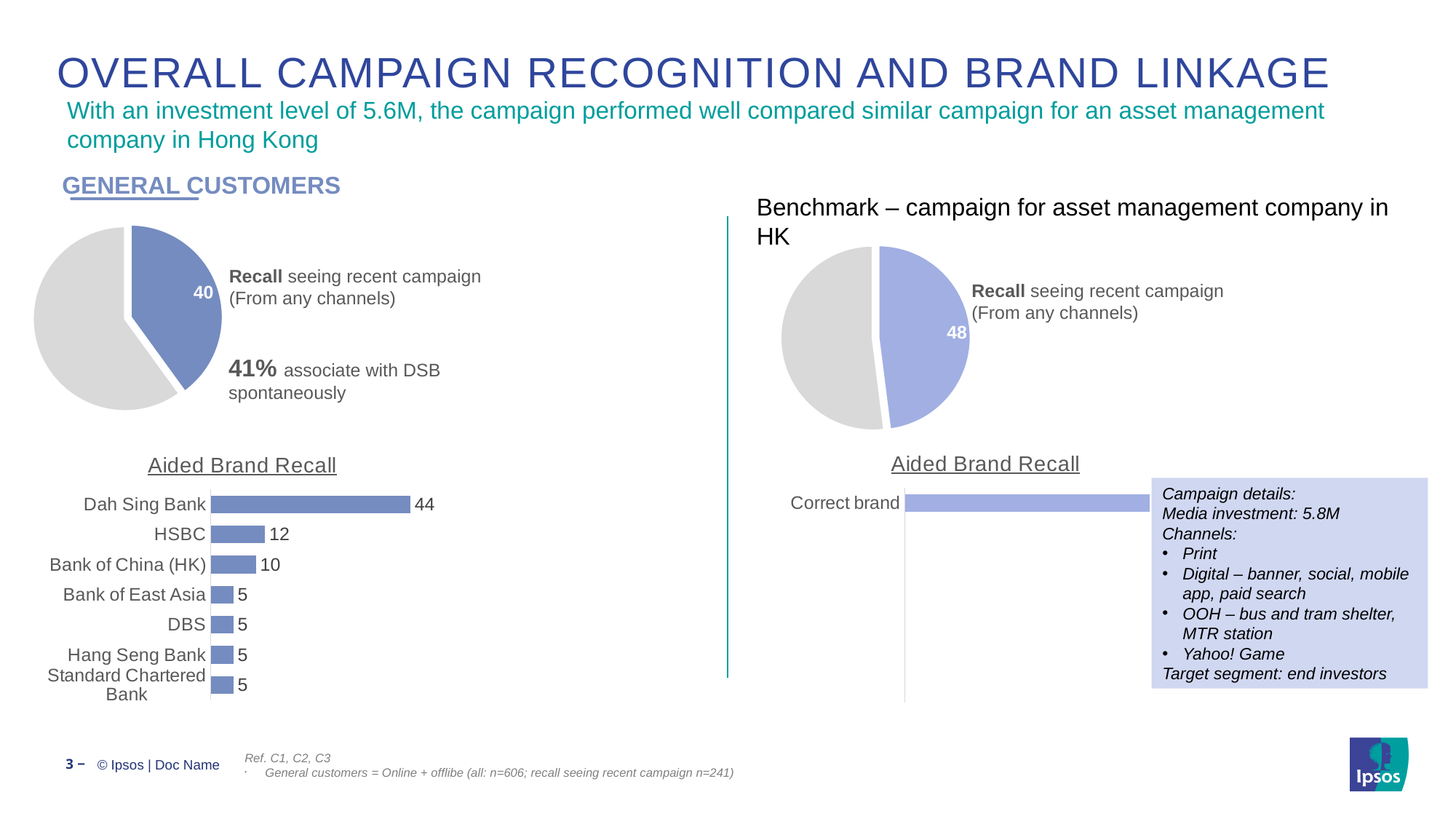
How many banks are listed in the General Customers Aided Brand Recall bar chart? 7 In the General Customers pie chart, what value is shown for the recall seeing recent campaign slice? 40 Which pie chart shows a larger recall value, the General Customers pie or the Benchmark pie? Benchmark In the General Customers Aided Brand Recall bar chart, what is the value for HSBC? 12 In the General Customers Aided Brand Recall bar chart, what is the value for Dah Sing Bank? 44 In the Benchmark pie chart, what value is shown for the recall seeing recent campaign slice? 48 In the General Customers Aided Brand Recall bar chart, what is the value for Bank of China (HK)? 10 In the General Customers Aided Brand Recall bar chart, which is larger, HSBC or Bank of China (HK)? HSBC In the General Customers Aided Brand Recall bar chart, what is the difference between Dah Sing Bank and HSBC? 32 What is the title of the bar chart on the left side of the slide? Aided Brand Recall What type of chart is the General Customers Aided Brand Recall chart? Bar chart In the General Customers Aided Brand Recall bar chart, which bank has the highest value? Dah Sing Bank